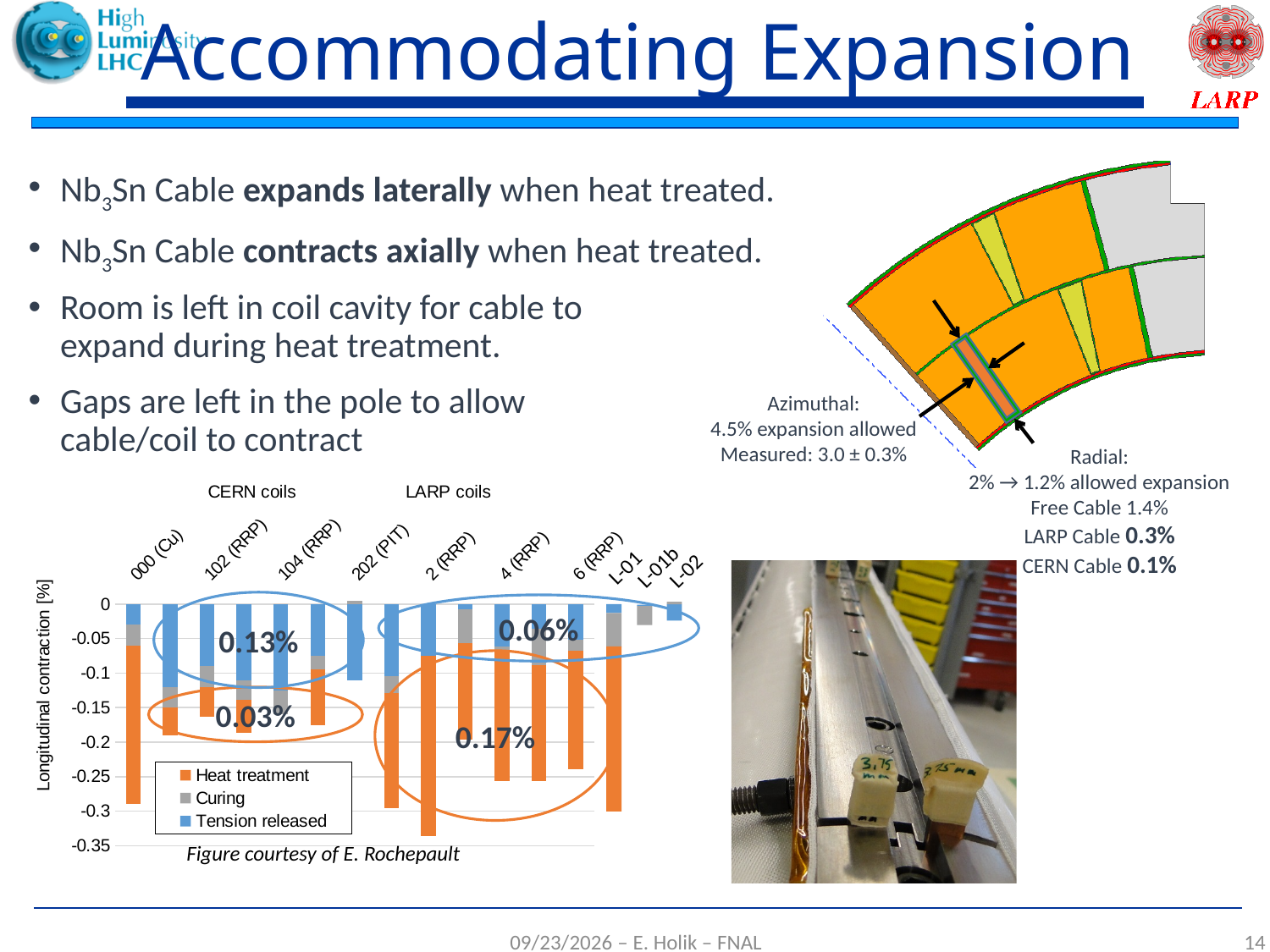
Which coil shows a larger total longitudinal contraction, 000 (Cu) or 202 (PIT)? 000 (Cu) Which series in the bar chart is shown in orange? Heat treatment Is the total longitudinal contraction for 202 (PIT) greater or less than -0.15? greater What is the label of the vertical axis of the bar chart? Longitudinal contraction [%] Is the total longitudinal contraction for L-02 greater or less than -0.05? greater Which coil shows a larger total longitudinal contraction, 2 (RRP) or 4 (RRP)? 2 (RRP) Is the total longitudinal contraction for 2 (RRP) greater or less than -0.3? less How many series does the legend of the longitudinal contraction chart list? 3 Which coil has the longest stacked bar (largest total longitudinal contraction) in the chart? 2 (RRP) What kind of chart is shown at the bottom left of the slide? Stacked bar chart